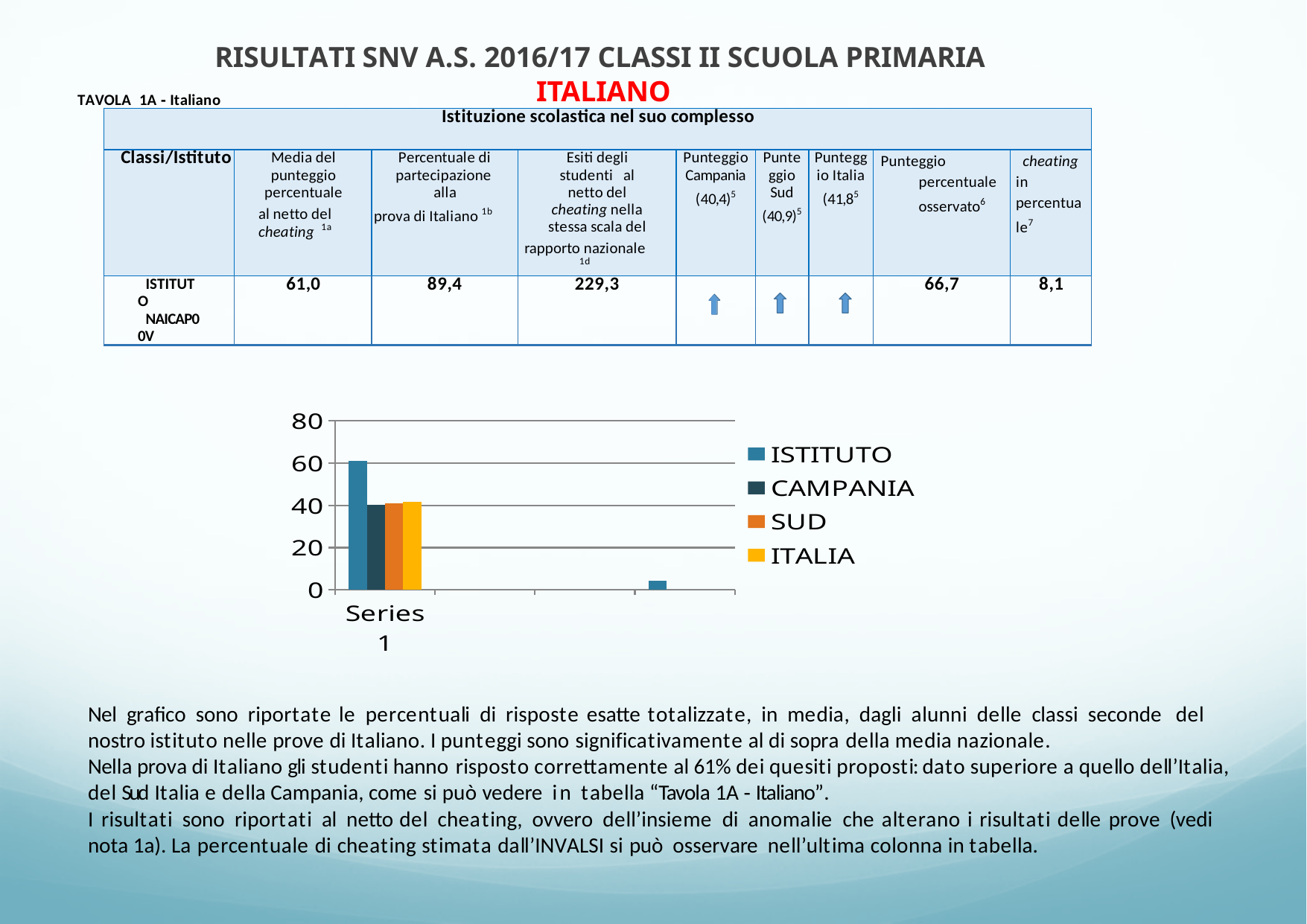
Is the value for CAMPANIA in the chart greater or less than 60? less Is the value for ITALIA in the chart greater or less than 20? greater Which is larger in the chart, the CAMPANIA bar or the ISTITUTO bar? ISTITUTO Is the value for SUD in the chart greater or less than 60? less What kind of chart is shown on the slide? bar chart How many series does the chart legend list? 4 Which is larger in the chart, the ISTITUTO bar or the ITALIA bar? ISTITUTO What is the highest value shown on the chart's vertical axis? 80 Which series has the highest bar in the chart? ISTITUTO What is the category label shown on the x axis of the chart? Series 1